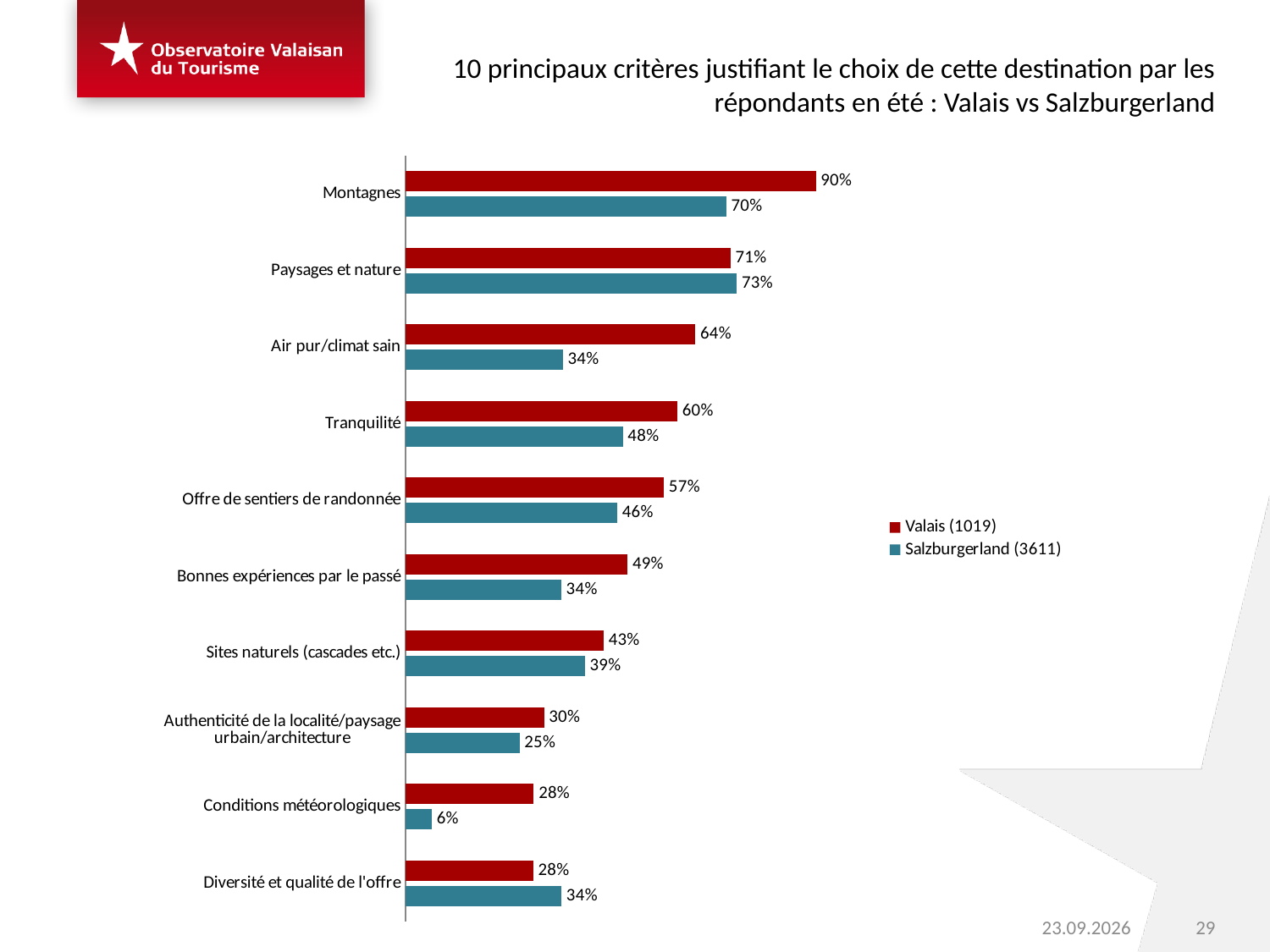
What is the value for Conditions météorologiques in the Salzburgerland (3611) series? 6% Which colour represents the Valais (1019) series? Red What is the value for Montagnes in the Valais (1019) series? 90% How many categories are shown on the chart? 10 For Diversité et qualité de l'offre, which series has the larger value, Valais (1019) or Salzburgerland (3611)? Salzburgerland (3611) How many series does the legend list? 2 Which category has the lowest value in the Salzburgerland (3611) series? Conditions météorologiques What is the value for Tranquilité in the Salzburgerland (3611) series? 48% For Paysages et nature, which series has the larger value, Valais (1019) or Salzburgerland (3611)? Salzburgerland (3611) What is the difference between the Valais (1019) and Salzburgerland (3611) values for Air pur/climat sain? 30% What kind of chart is shown on the slide? Bar chart Which category has the highest value in the Valais (1019) series? Montagnes